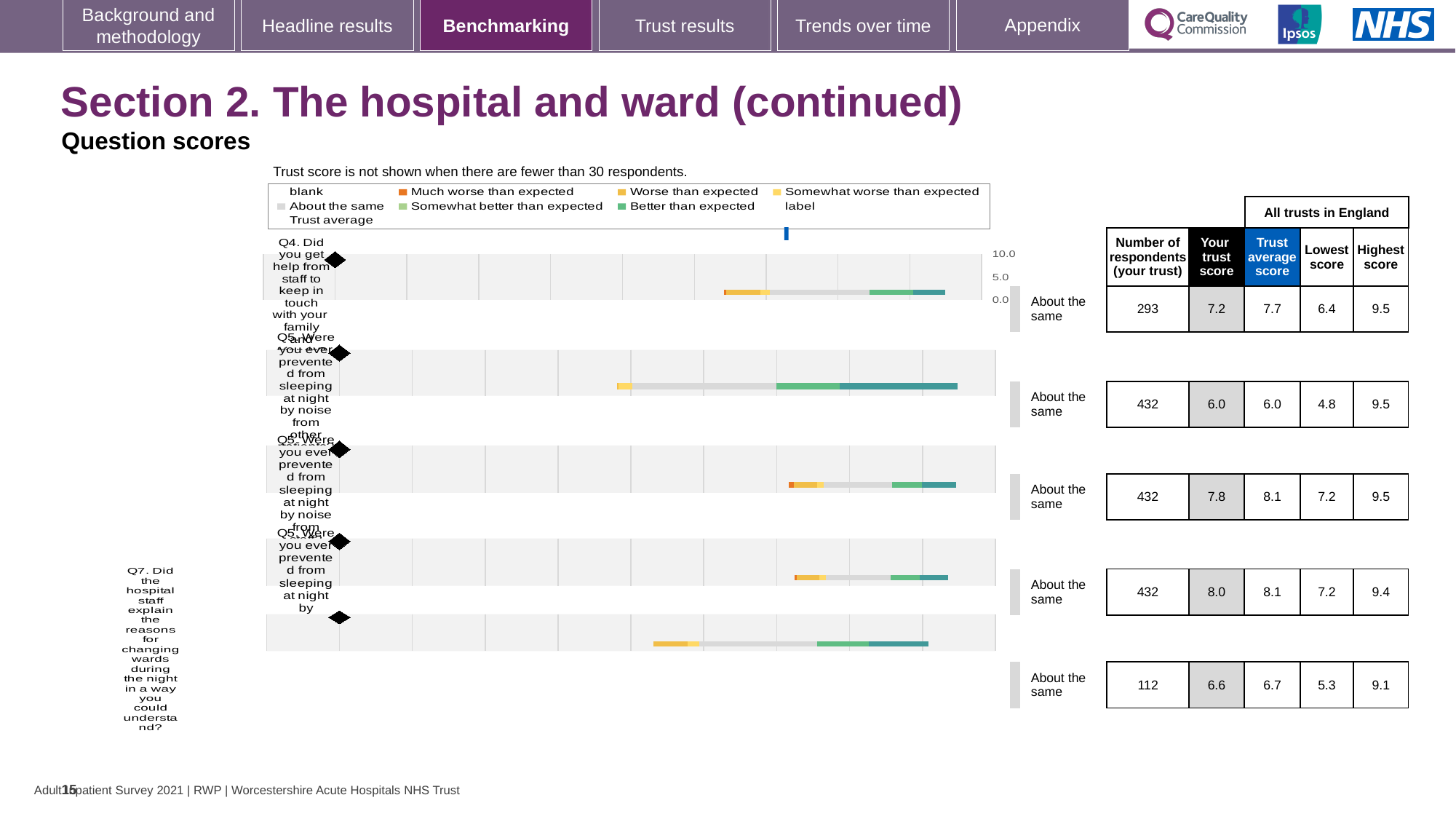
How many question rows (bars) are plotted in the chart? 5 What is the trust's score for Q7 (explaining reasons for changing wards during the night)? 6.6 What is the trust average score for Q4 (help from staff to keep in touch with family and friends)? 7.7 Which colour in the legend represents 'Much worse than expected'? orange What is the number of respondents for Q7 (explaining reasons for changing wards during the night)? 112 Which question row has the lowest number of respondents? Q7 What is the highest tick value shown on the chart's score axis? 10.0 What kind of chart is used to show the question scores on this slide? bar chart What is the number of respondents for Q4 (help from staff to keep in touch with family and friends)? 293 What is the difference between the highest score and the lowest score for Q4? 3.1 What is the trust's score for Q4 (help from staff to keep in touch with family and friends)? 7.2 For Q4, which is larger: the trust's own score or the trust average score? Trust average score